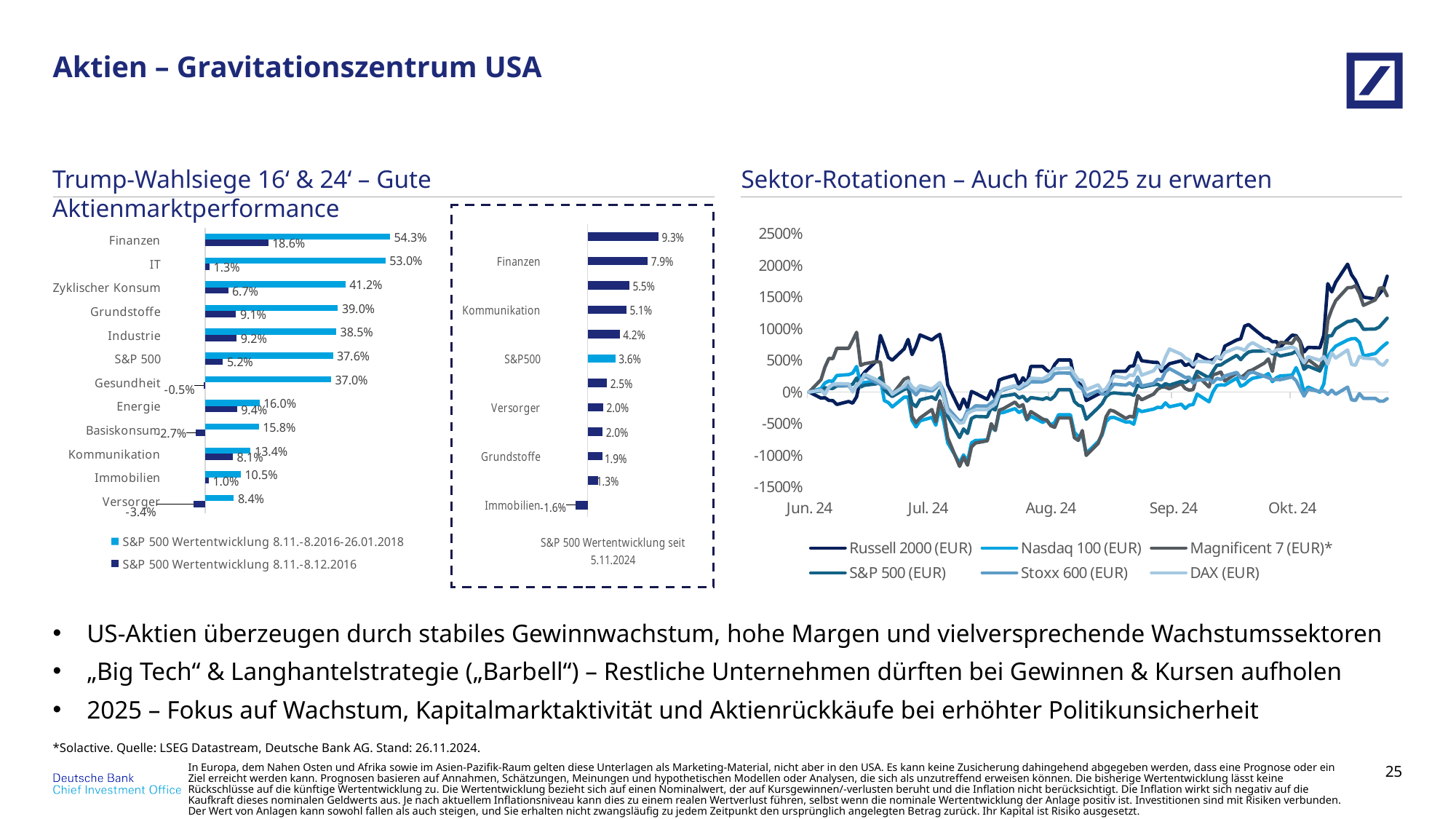
In the left chart 'Trump-Wahlsiege 16' & 24'', how many series does the legend list? 2 What kind of chart is the right chart 'Sektor-Rotationen – Auch für 2025 zu erwarten'? Line chart In the middle chart 'S&P 500 Wertentwicklung seit 5.11.2024', what is the highest value shown? 9.3% In the left chart 'Trump-Wahlsiege 16' & 24'', what is the value for Finanzen in the series 'S&P 500 Wertentwicklung 8.11.-8.2016-26.01.2018'? 54.3% In the left chart 'Trump-Wahlsiege 16' & 24'', how many categories are shown? 12 In the middle chart 'S&P 500 Wertentwicklung seit 5.11.2024', what is the value for Immobilien? -1.6% In the left chart 'Trump-Wahlsiege 16' & 24'', what is the difference between the two series values for Finanzen? 35.7 percentage points In the right chart 'Sektor-Rotationen – Auch für 2025 zu erwarten', how many series does the legend list? 6 In the left chart 'Trump-Wahlsiege 16' & 24'', which category has the lowest value in the series 'S&P 500 Wertentwicklung 8.11.-8.12.2016'? Versorger In the left chart 'Trump-Wahlsiege 16' & 24'', what is the value for IT in the series 'S&P 500 Wertentwicklung 8.11.-8.12.2016'? 1.3% In the left chart 'Trump-Wahlsiege 16' & 24'', which is larger for Energie: the 8.11.-8.2016-26.01.2018 value or the 8.11.-8.12.2016 value? 8.11.-8.2016-26.01.2018 (16.0%) In the left chart 'Trump-Wahlsiege 16' & 24'', which category has the highest value in the series 'S&P 500 Wertentwicklung 8.11.-8.2016-26.01.2018'? Finanzen